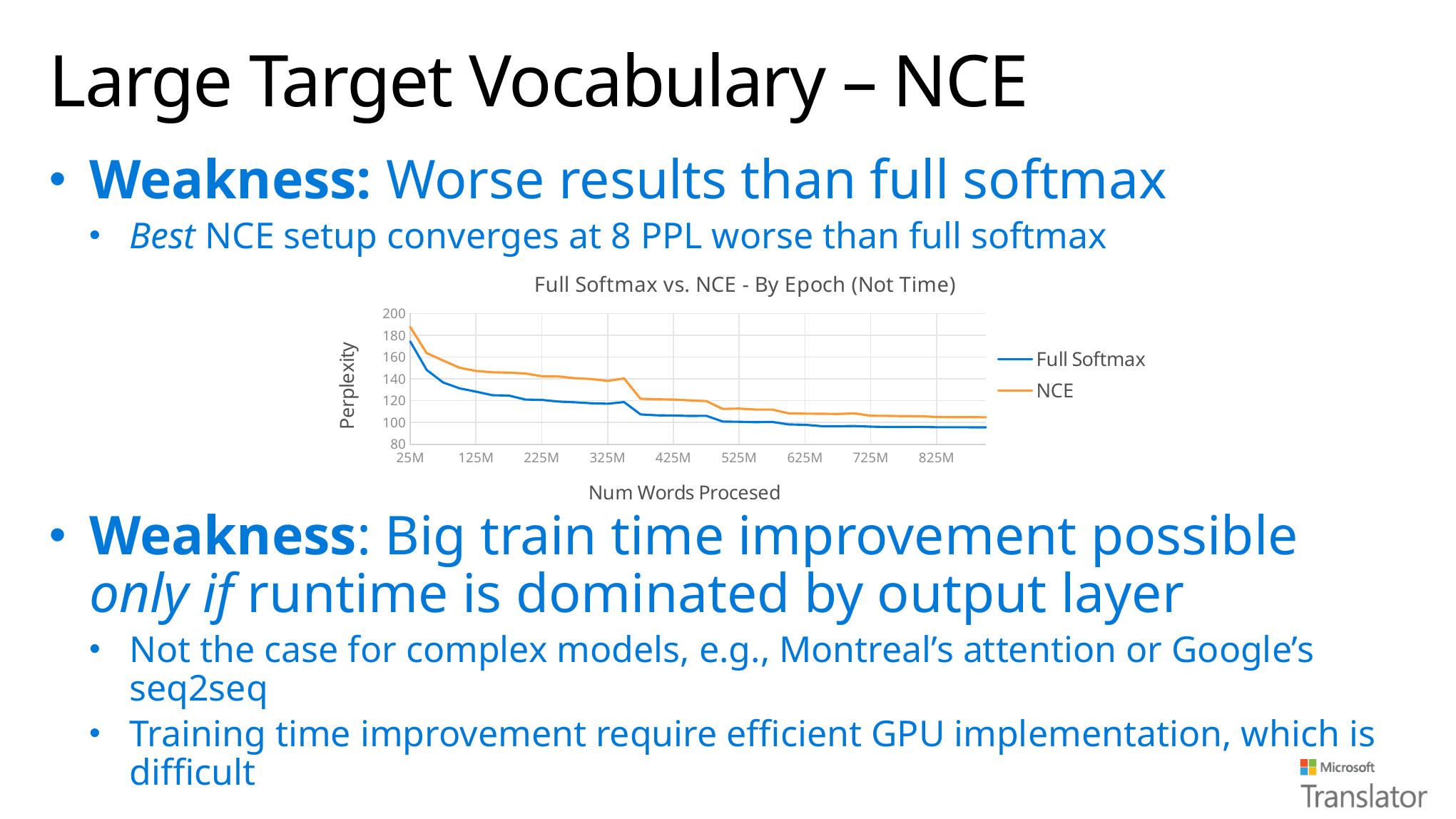
What kind of chart is shown on the slide? line chart Does the perplexity of the Full Softmax series rise or fall as the number of words processed increases? fall Is the perplexity of the Full Softmax series at 825M words processed greater or less than 100? less How many series does the chart's legend list? 2 Is the perplexity of the NCE series at 825M words processed greater or less than 100? greater Is the perplexity of the Full Softmax series at 325M words processed greater or less than 140? less At 825M words processed, which series has the higher perplexity, Full Softmax or NCE? NCE Does the perplexity of the NCE series rise or fall along the x axis? fall What is the title of the chart? Full Softmax vs. NCE - By Epoch (Not Time) At 25M words processed, which series has the lower perplexity, Full Softmax or NCE? Full Softmax What is the label of the y axis of the chart? Perplexity